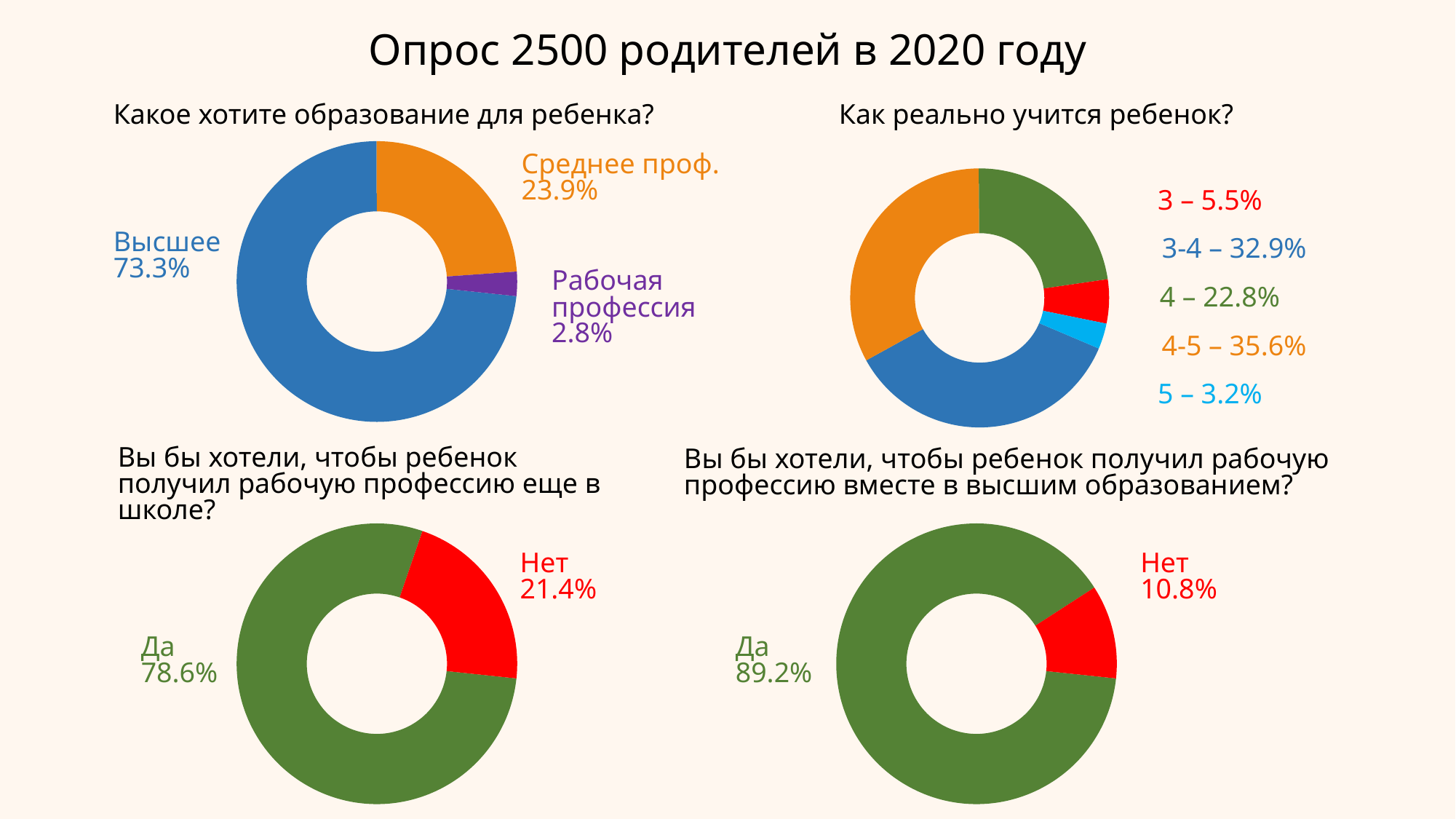
In the top-right chart 'Как реально учится ребенок?', what is the difference between the shares for '3-4' and '4'? 10.1% What kind of chart is used for the bottom-left chart about getting a working profession while still at school? Donut (pie) chart In the top-right chart 'Как реально учится ребенок?', which category has the smallest share? 5 In the bottom-left chart about getting a working profession while still at school, what share answered 'Нет'? 21.4% In the top-right chart 'Как реально учится ребенок?', how many categories are listed? 5 In the top-left chart 'Какое хотите образование для ребенка?', how many categories are shown? 3 In the bottom-right chart about getting a working profession together with higher education, what share answered 'Да'? 89.2% In the top-left chart 'Какое хотите образование для ребенка?', what share is labelled 'Рабочая профессия'? 2.8% In the top-left chart 'Какое хотите образование для ребенка?', what share of parents chose 'Высшее'? 73.3% In the top-right chart 'Как реально учится ребенок?', which category has the largest share? 4-5 In the top-right chart 'Как реально учится ребенок?', what is the value for '4-5'? 35.6% In the top-left chart 'Какое хотите образование для ребенка?', which category has the smallest share? Рабочая профессия